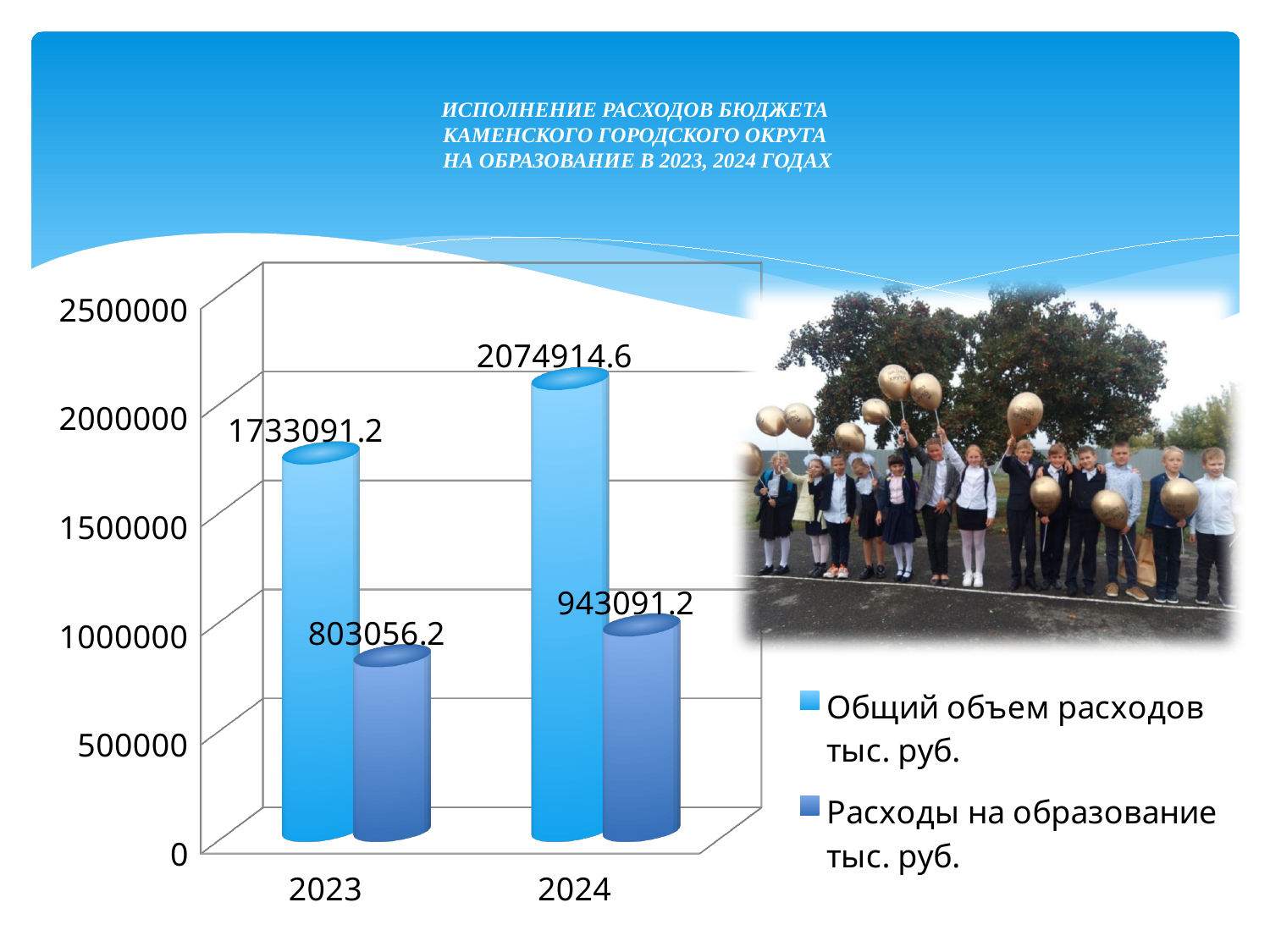
In which year is Расходы на образование тыс. руб. lowest? 2023 Does Расходы на образование тыс. руб. rise or fall from 2023 to 2024? rise What is the difference between Общий объем расходов тыс. руб. and Расходы на образование тыс. руб. in 2023? 930035.0 What is the value of Общий объем расходов тыс. руб. for 2024? 2074914.6 Which is larger in 2024: Общий объем расходов тыс. руб. or Расходы на образование тыс. руб.? Общий объем расходов тыс. руб. What is the value of Расходы на образование тыс. руб. for 2024? 943091.2 What kind of chart is shown on the slide? bar chart By how much did Общий объем расходов тыс. руб. increase from 2023 to 2024? 341823.4 How many series does the legend list? 2 In which year is Общий объем расходов тыс. руб. highest? 2024 What is the value of Общий объем расходов тыс. руб. for 2023? 1733091.2 What is the value of Расходы на образование тыс. руб. for 2023? 803056.2